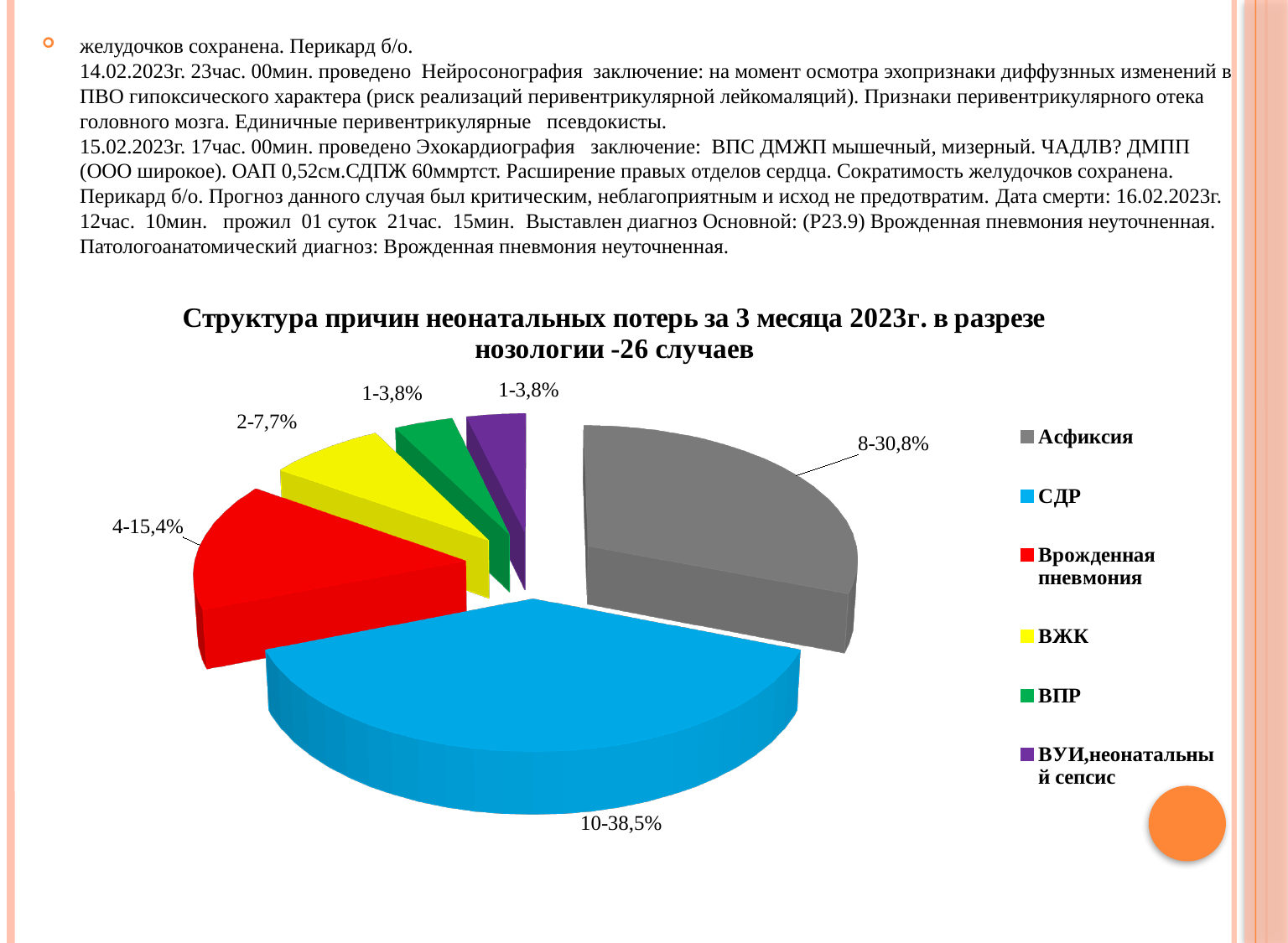
What is the total number of cases stated in the chart title? 26 What type of chart is shown on the slide? pie chart What percentage share does the ВПР slice have in the pie chart? 3,8% How many cases does the СДР slice represent more than the Асфиксия slice? 2 What is the data label for the СДР slice of the pie chart? 10-38,5% Which category has the larger share: Асфиксия or Врожденная пневмония? Асфиксия How many categories are shown in the pie chart legend? 6 What colour is the ВУИ,неонатальный сепсис slice in the pie chart? purple Which category has the largest slice in the pie chart? СДР What is the data label for the Врожденная пневмония slice of the pie chart? 4-15,4% What is the data label for the Асфиксия slice of the pie chart? 8-30,8% What is the data label for the ВЖК slice of the pie chart? 2-7,7%